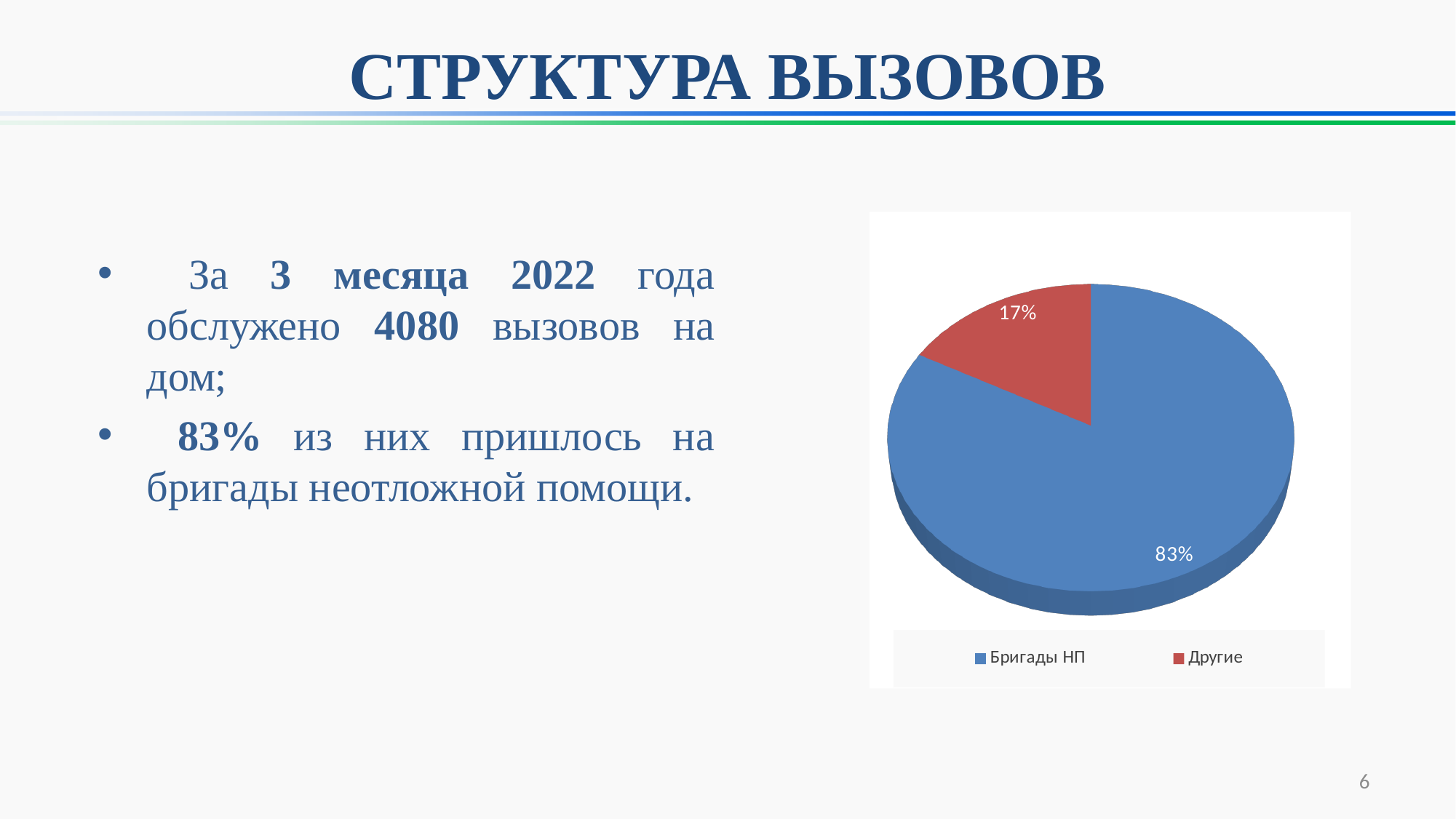
What is the difference in percentage points between the "Бригады НП" slice and the "Другие" slice? 66 What kind of chart is shown on the slide? pie chart Which is larger, the "Бригады НП" slice or the "Другие" slice? Бригады НП What share of the pie does "Другие" have? 17% What colour is the "Бригады НП" slice in the pie chart? blue Which slice of the pie is the largest? Бригады НП What share of the pie does "Бригады НП" have? 83% Which slice of the pie is the smallest? Другие How many slices does the pie chart have? 2 What colour is the "Другие" slice in the pie chart? red How many entries does the legend list? 2